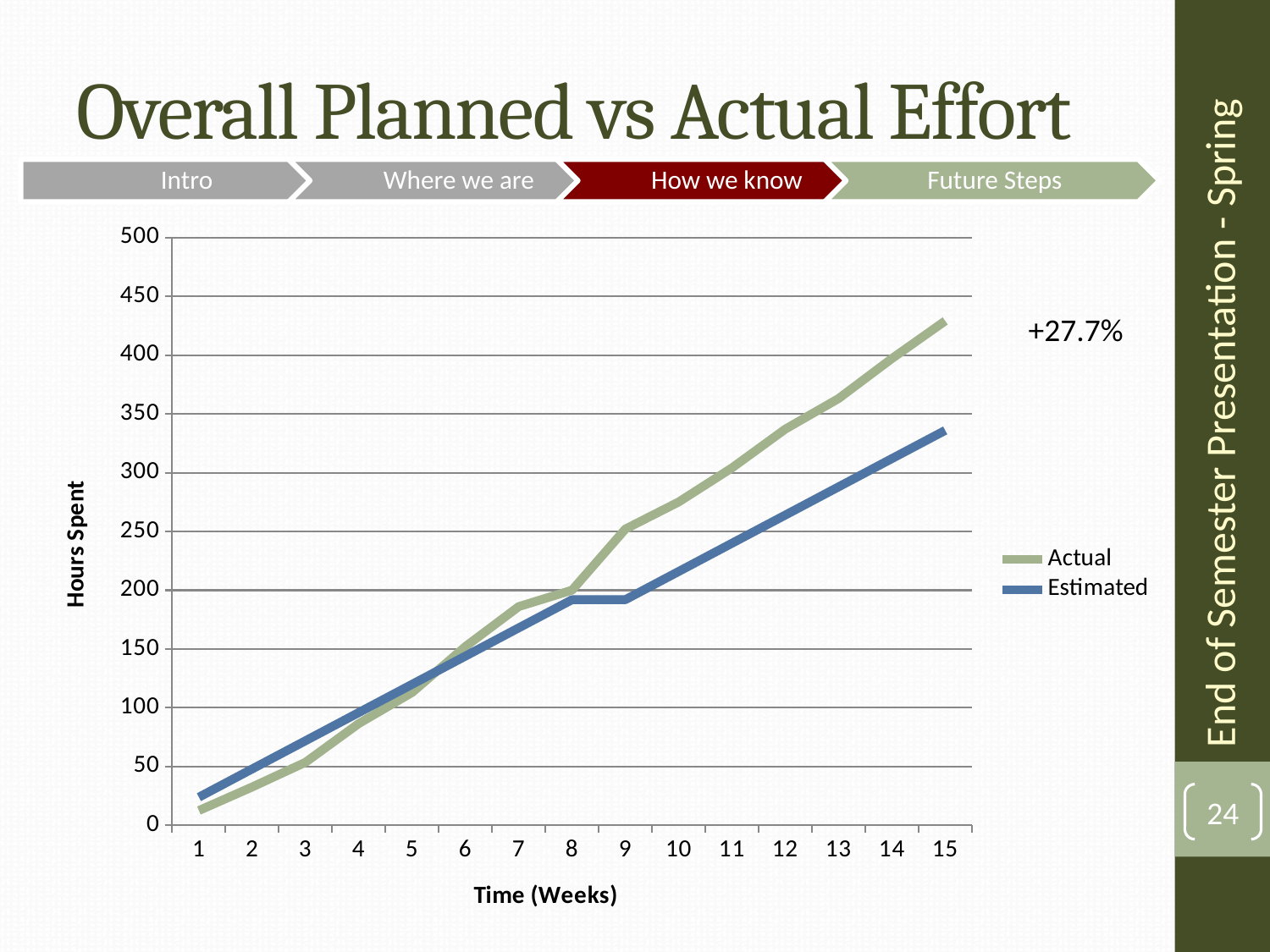
What kind of chart is shown on the slide? line chart At week 15, which series has the higher value, Actual or Estimated? Actual Does the Actual series rise or fall from week 1 to week 15? rise How many weeks are plotted along the x axis? 15 Is the Estimated value at week 15 greater or less than 350? less Is the Actual value at week 1 greater or less than 50? less At week 3, which series has the higher value, Actual or Estimated? Estimated How many series does the legend list? 2 At which week does the Actual series reach its highest value? 15 Is the Actual value at week 15 greater or less than 400? greater What is the title of the y axis? Hours Spent